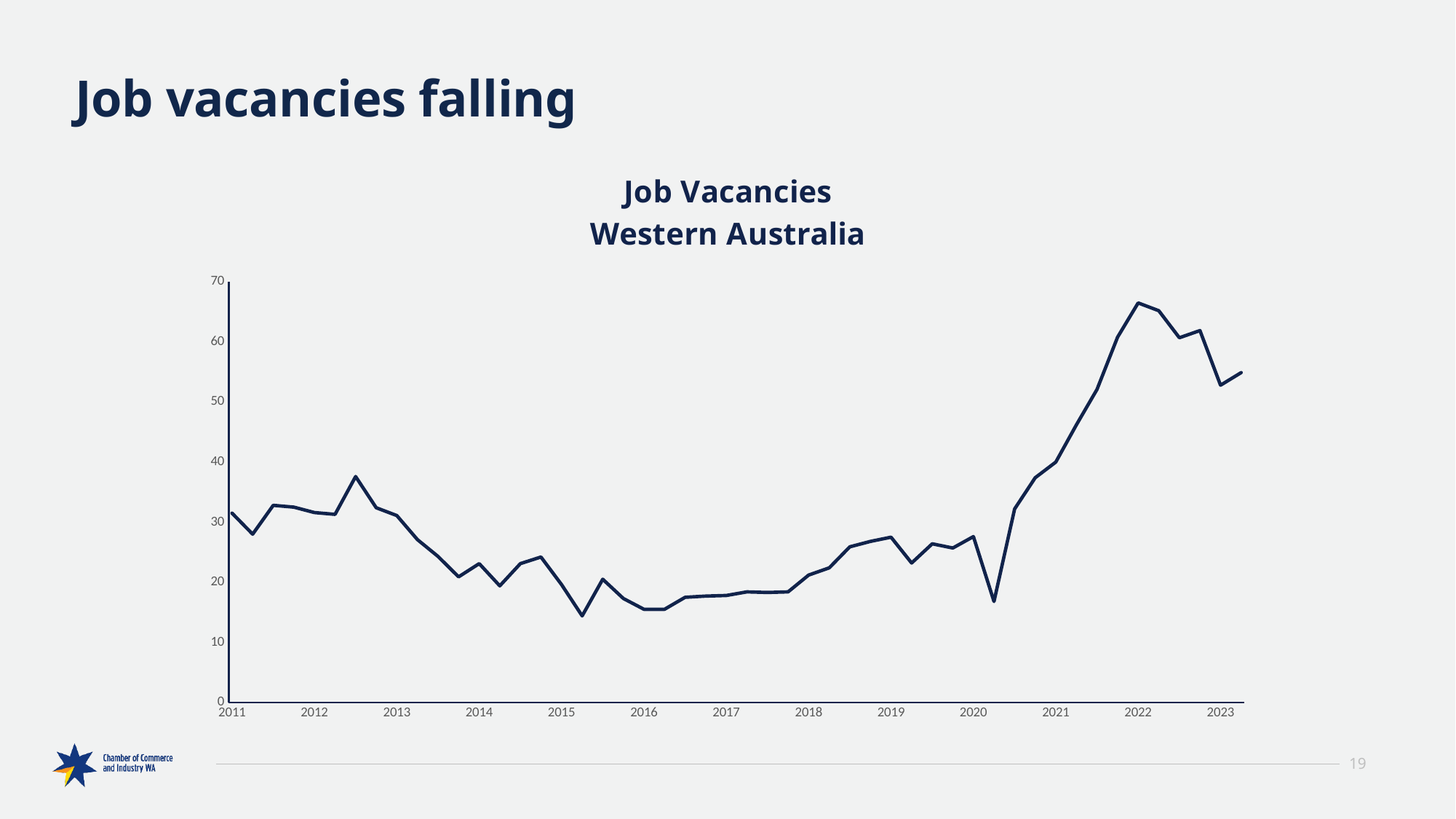
Is the value at the start of 2022 greater or less than 60? greater Is the value at the start of 2016 greater or less than 20? less What is the title of the chart? Job Vacancies Western Australia Is the value at the start of 2019 greater or less than 30? less How many year labels are shown on the x axis? 13 What kind of chart is shown on the slide? line chart Does the line rise or fall between 2020 and 2022? rise Which is larger, the value at the start of 2022 or the value at the start of 2016? 2022 In which year does the line reach its highest point? 2022 Does the line rise or fall between 2022 and 2023? fall